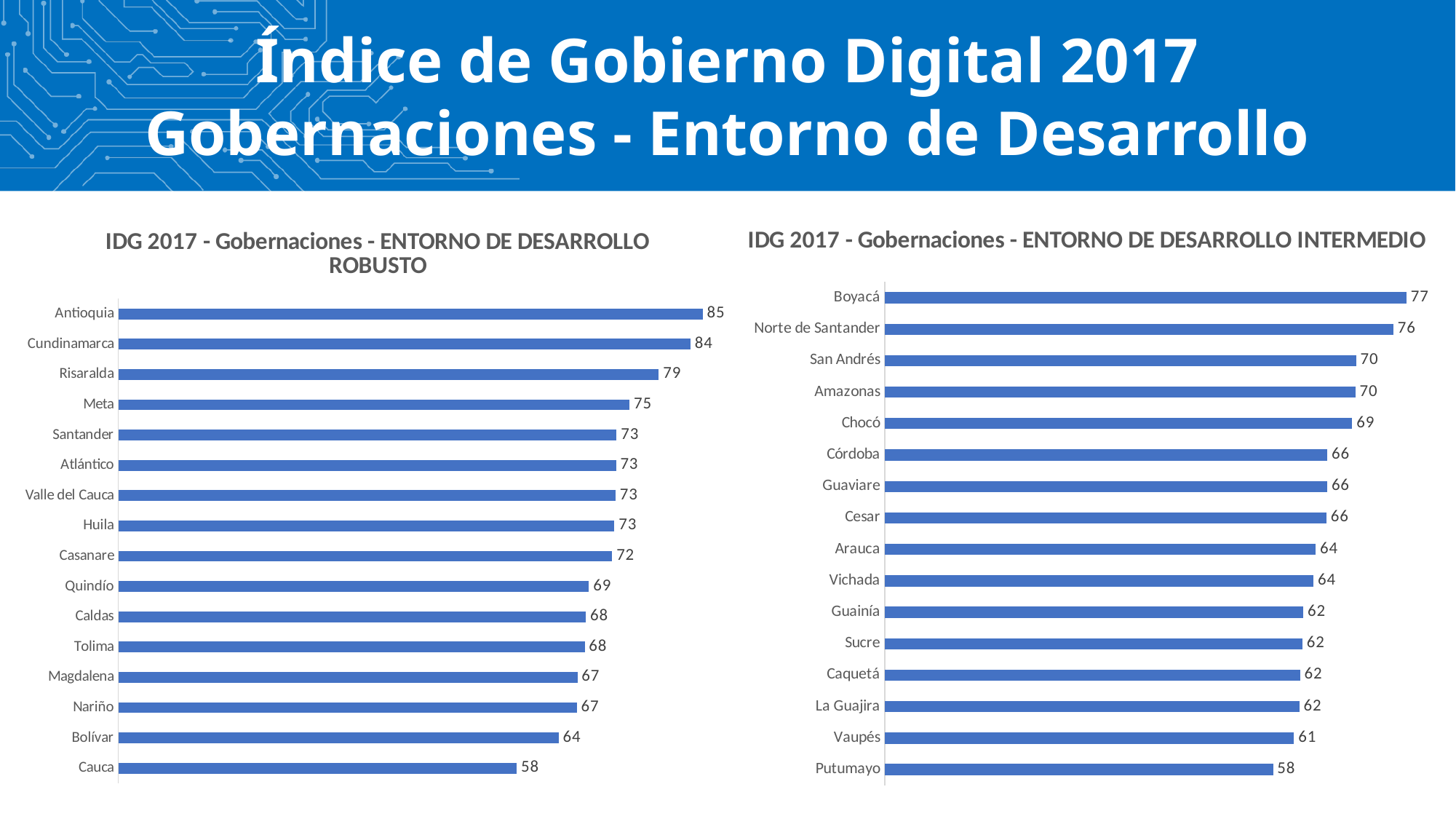
In the 'ENTORNO DE DESARROLLO INTERMEDIO' chart, which category has the highest value? Boyacá How many categories are shown in the 'ENTORNO DE DESARROLLO INTERMEDIO' chart? 16 What kind of chart is the 'ENTORNO DE DESARROLLO ROBUSTO' chart? Bar chart In the 'ENTORNO DE DESARROLLO INTERMEDIO' chart, what is the difference between Boyacá and Vaupés? 16 In the 'ENTORNO DE DESARROLLO ROBUSTO' chart, which category has the lowest value? Cauca In the 'ENTORNO DE DESARROLLO INTERMEDIO' chart, which category has the lowest value? Putumayo In the 'ENTORNO DE DESARROLLO INTERMEDIO' chart, what is the value for Chocó? 69 How many categories are shown in the 'ENTORNO DE DESARROLLO ROBUSTO' chart? 16 In the 'ENTORNO DE DESARROLLO INTERMEDIO' chart, which is larger, Arauca or Guainía? Arauca In the 'ENTORNO DE DESARROLLO ROBUSTO' chart, what is the difference between Antioquia and Cauca? 27 In the 'ENTORNO DE DESARROLLO ROBUSTO' chart, which is larger, Risaralda or Meta? Risaralda In the 'ENTORNO DE DESARROLLO ROBUSTO' chart, what is the value for Antioquia? 85